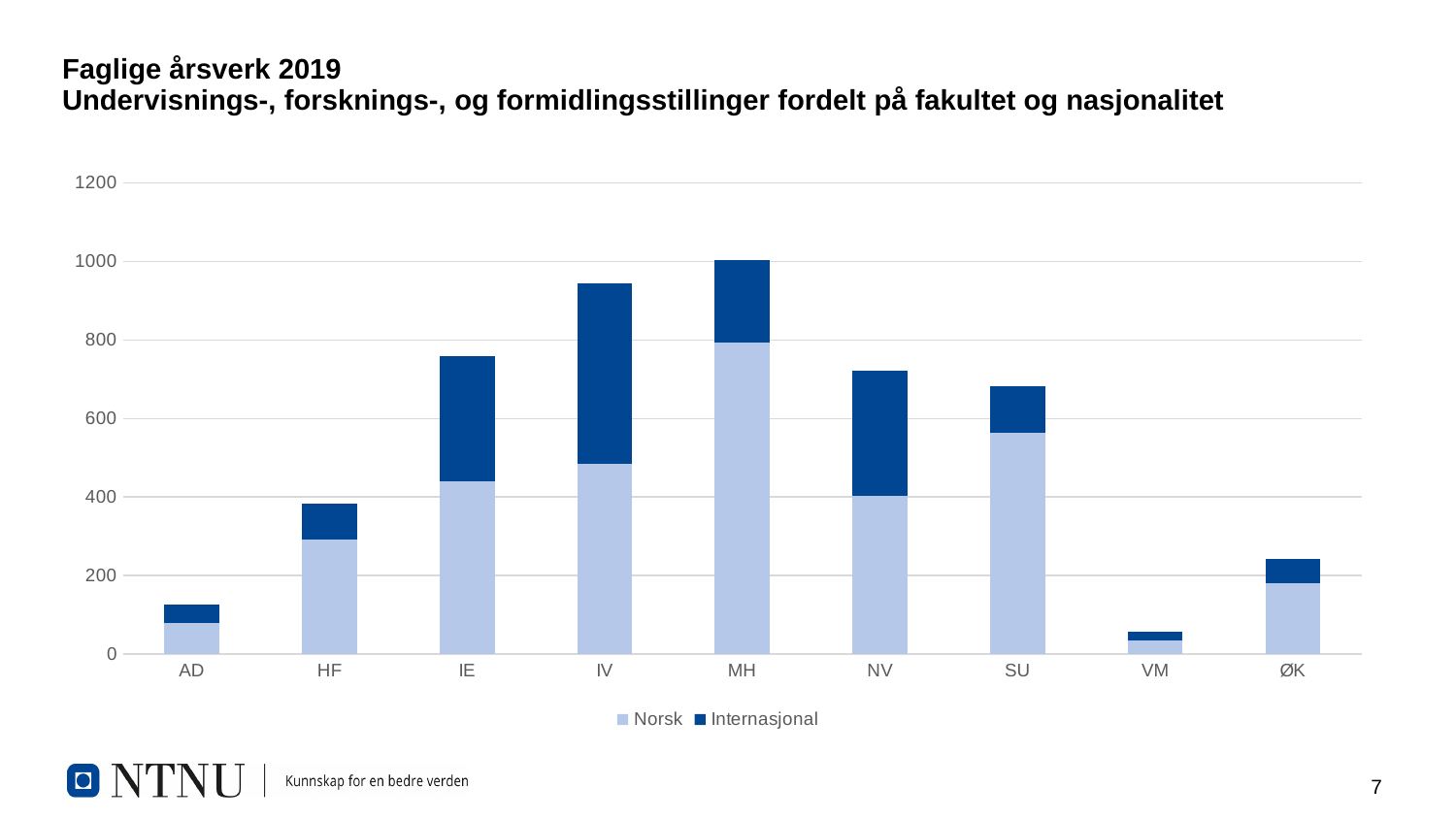
Is the total value for AD greater or less than 200? less Is the total value for IE greater or less than 600? greater Which faculty has the tallest total bar? MH Which has the larger Internasjonal segment, IV or MH? IV How many faculties (categories) are shown on the x axis? 9 Is the Norsk value for SU greater or less than 400? greater What are the two legend entries of the chart? Norsk and Internasjonal How many series does the legend list? 2 Which has the larger Norsk segment, SU or NV? SU What kind of chart is shown on the slide? Stacked bar chart Which faculty has the shortest total bar? VM